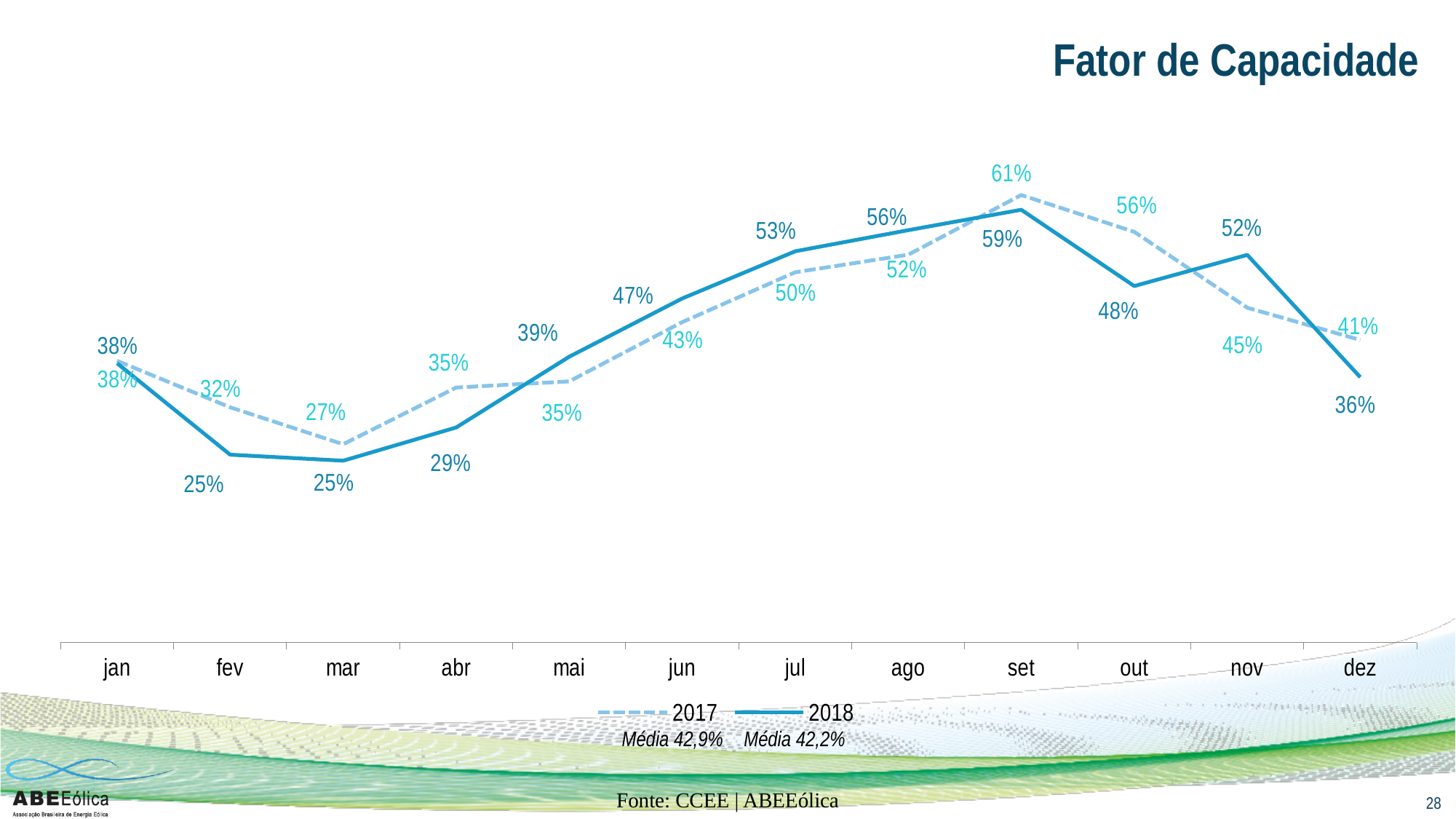
In which month does the 2017 series reach its lowest value? mar What is the 2018 value for nov? 52% What is the difference between the 2017 and 2018 values for out? 8% In which month does the 2018 series reach its highest value? set What is the 2017 value for mar? 27% What is the 2018 value for set? 59% In which month does the 2017 series reach its highest value? set What kind of chart is shown on the slide? line chart What is the average (Média) shown for the 2017 series? 42,9% How many months are shown on the x axis? 12 How many series does the legend list? 2 Which series has the larger value in nov, 2017 or 2018? 2018